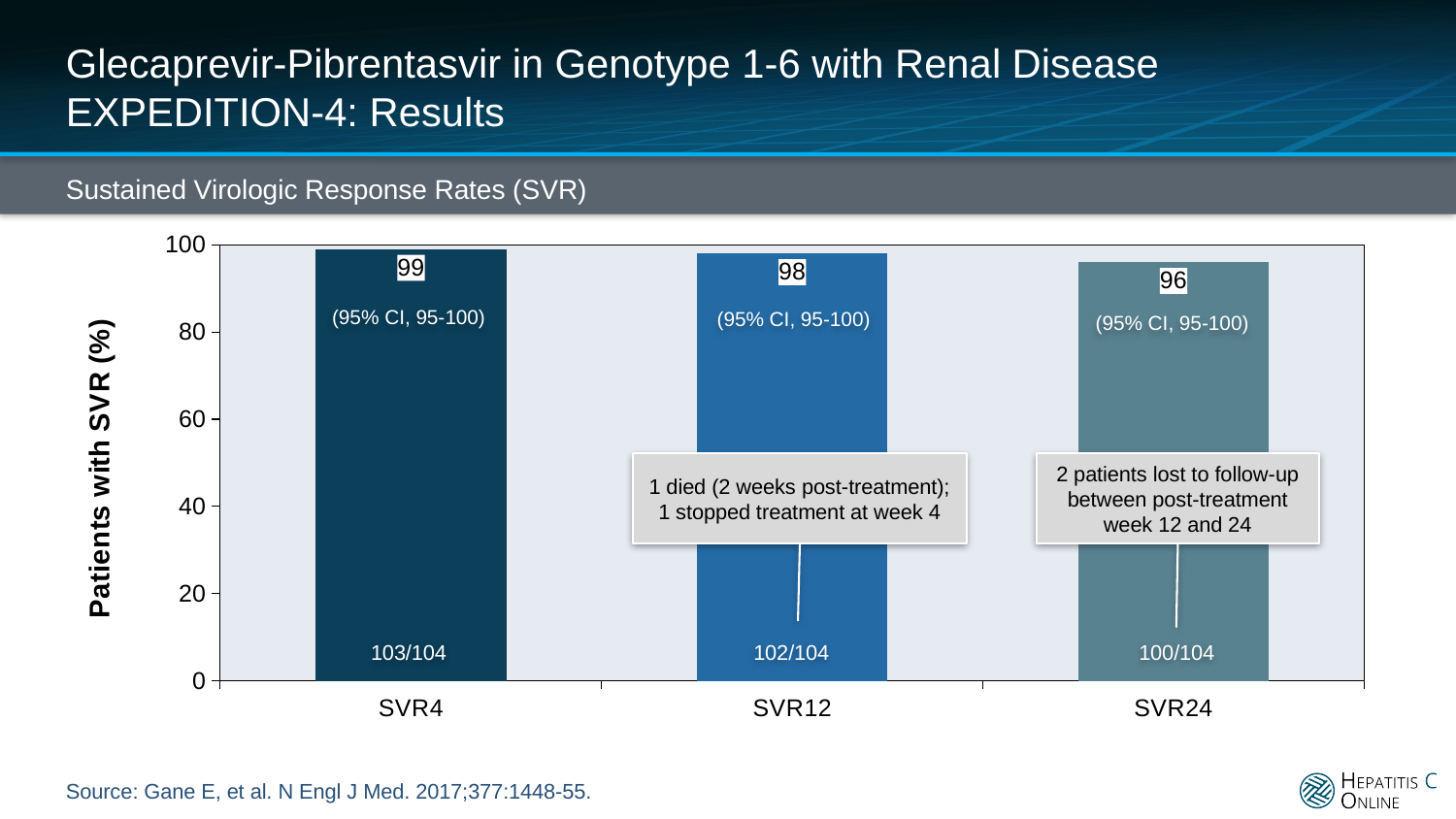
Which is larger, the SVR rate for SVR12 or for SVR24? SVR12 What is the difference in SVR rate between SVR4 and SVR24? 3 Which time point has the lowest SVR rate? SVR24 What fraction of patients achieved SVR12? 102/104 Which time point has the highest SVR rate? SVR4 What is the label of the y axis? Patients with SVR (%) What is the SVR rate (%) for SVR12? 98 What is the SVR rate (%) for SVR24? 96 What kind of chart is shown on the slide? Bar chart How many time points (categories) are shown on the x axis? 3 What is the SVR rate (%) for SVR4? 99 Do the SVR rates rise or fall from SVR4 to SVR24? Fall